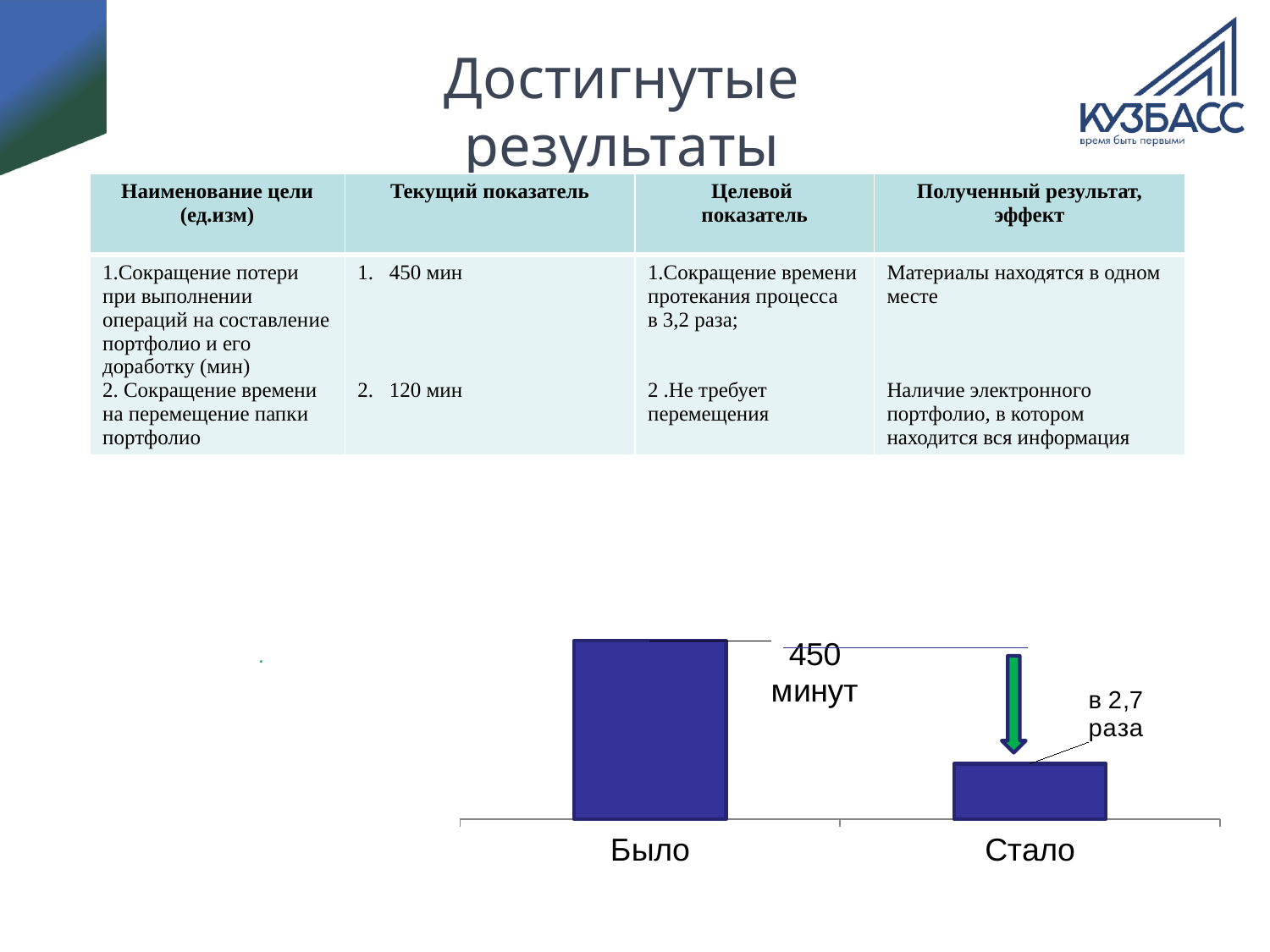
What value is labelled on the bar for Было? 450 минут Which category has the shortest bar in the chart? Стало Which bar is taller, Было or Стало? Было What are the two category labels on the x axis of the chart? Было, Стало Do the bar values rise or fall from Было to Стало? fall Which category has the tallest bar in the chart? Было What kind of chart is shown at the bottom of the slide? bar chart What text is written next to the Стало bar in the chart? в 2,7 раза How many categories are shown on the x axis of the bar chart? 2